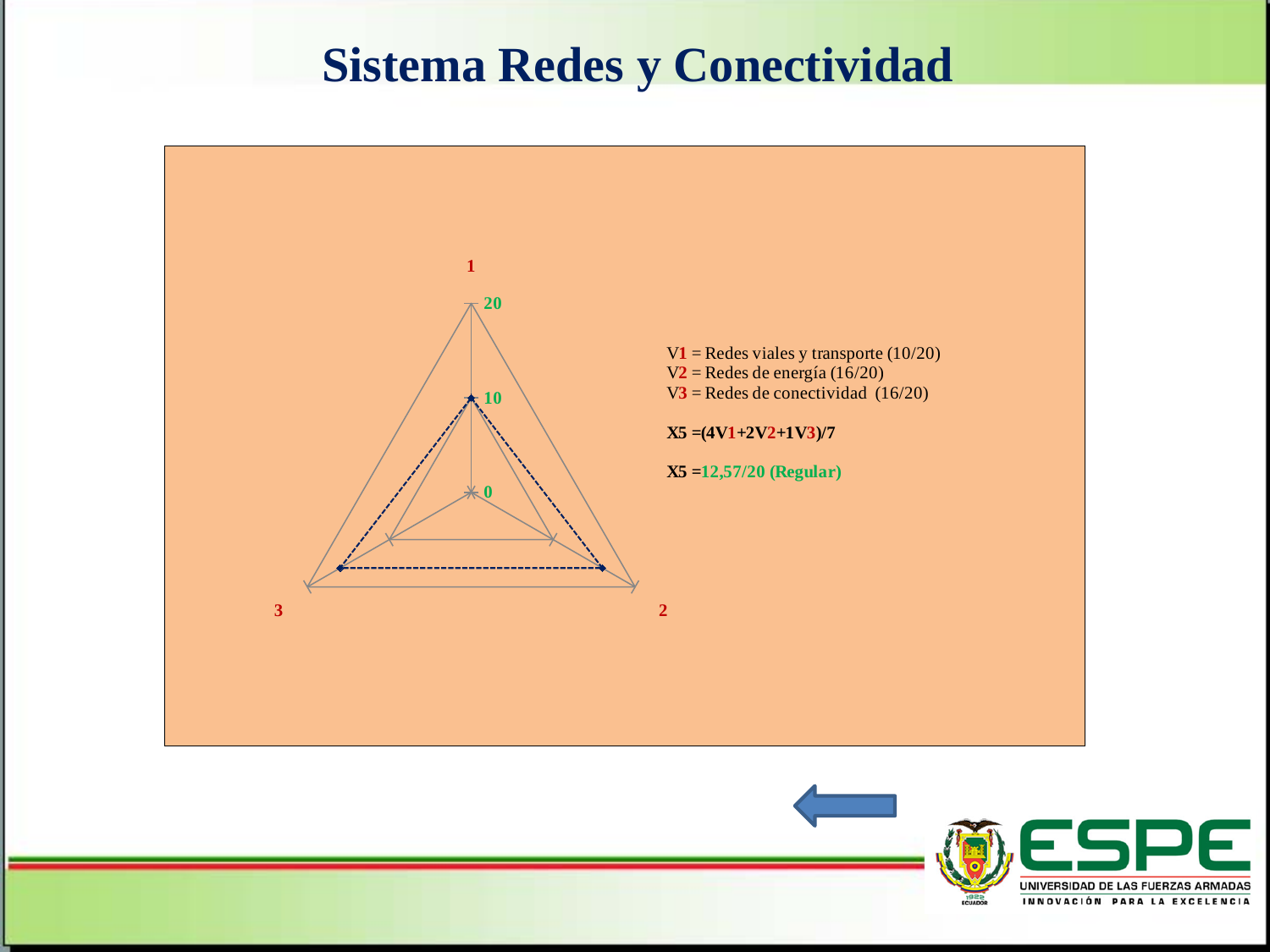
Which has the larger plotted value, axis 1 or axis 2? axis 2 How many axes (categories) does the radar chart have? 3 Is the plotted value on axis 1 greater or less than 20? less What is the title of the slide containing the radar chart? Sistema Redes y Conectividad What kind of chart is shown on the slide? radar chart Is the plotted value on axis 2 greater or less than 10? greater What is the maximum value shown on the radar chart's scale? 20 What is the plotted value on axis 1 of the radar chart? 10 Is the plotted value on axis 3 greater or less than 10? greater Which axis has the lowest plotted value in the radar chart? 1